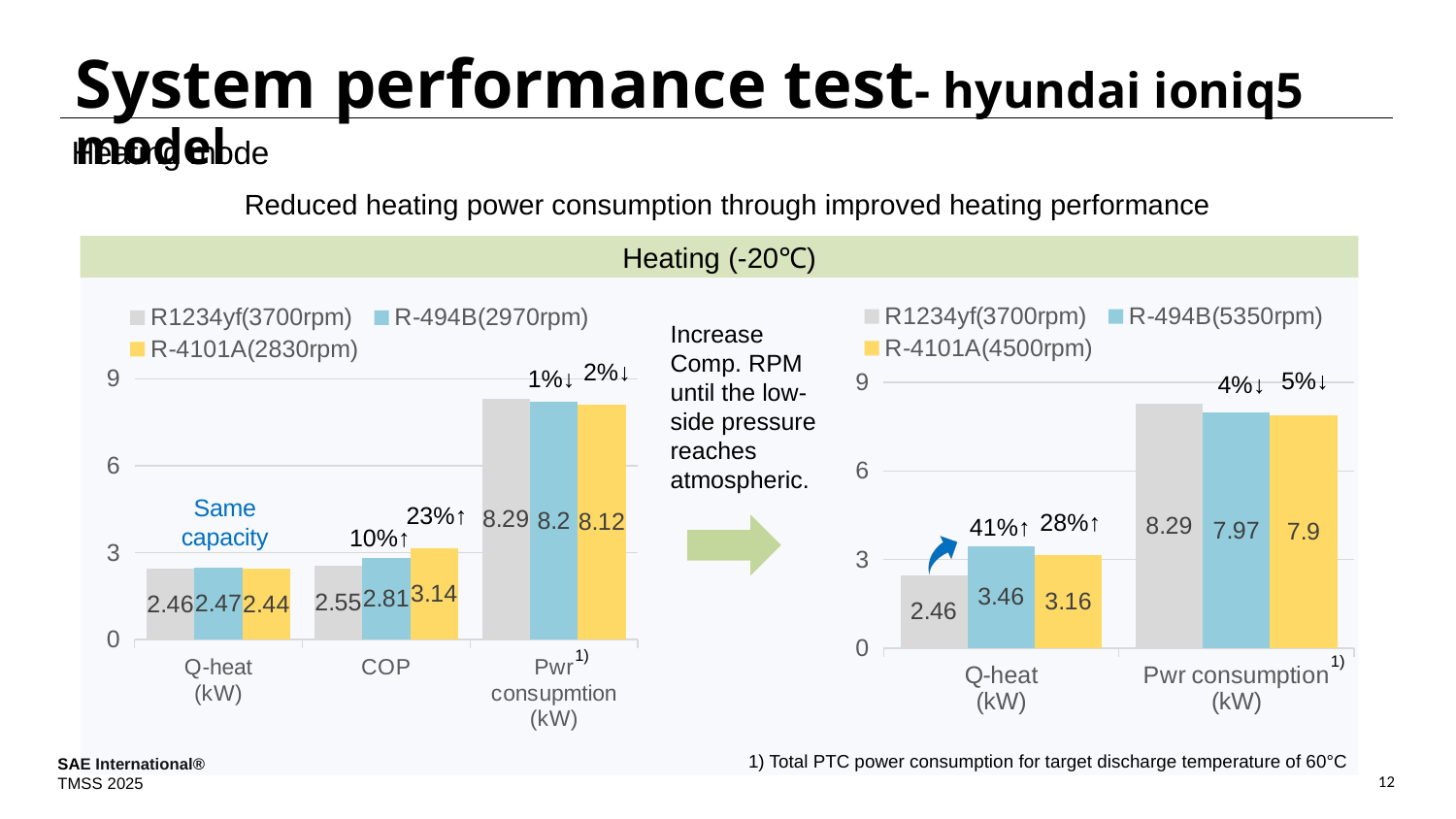
In the right chart, what is the Pwr consumption (kW) value for R-4101A(4500rpm)? 7.9 In the right chart, which is larger: the Pwr consumption (kW) value for R1234yf(3700rpm) or for R-494B(5350rpm)? R1234yf(3700rpm) What type of chart is the right chart? Bar chart In the left chart, what is the Pwr consumption (kW) value for R1234yf(3700rpm)? 8.29 How many series does the legend of the right chart list? 3 In the left chart, what is the COP value for R-4101A(2830rpm)? 3.14 In the right chart, what is the Q-heat (kW) value for R-494B(5350rpm)? 3.46 How many categories are shown on the x axis of the left chart? 3 In the right chart, what is the difference between the Q-heat (kW) values of R-494B(5350rpm) and R1234yf(3700rpm)? 1 In the right chart, which series has the lowest Q-heat (kW) value? R1234yf(3700rpm) In the left chart, which series has the highest COP value? R-4101A(2830rpm) In the left chart, what is the difference between the COP values of R-4101A(2830rpm) and R1234yf(3700rpm)? 0.59